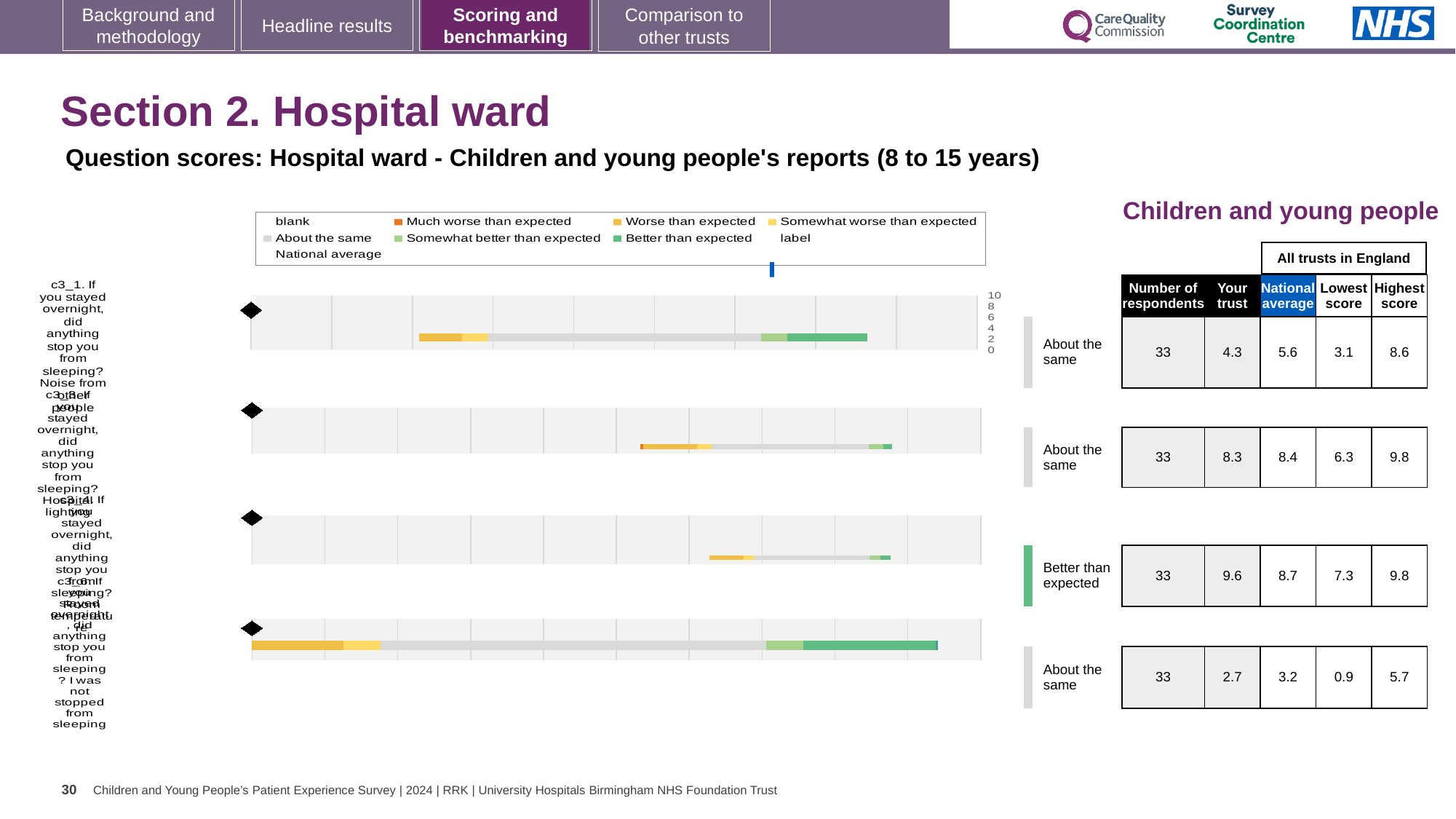
For the first (top) chart, what is the national average score? 5.6 Which chart has the lowest 'Your trust' score? the fourth (bottom) chart (2.7) For the third chart from the top, which is larger: the 'Your trust' score or the national average? Your trust For the fourth (bottom) chart, what is the lowest score among all trusts in England? 0.9 What kind of chart is used to show the question scores on this slide? bar chart Which chart is rated 'Better than expected' rather than 'About the same'? the third chart from the top For the second chart from the top, what is the highest score among all trusts in England? 9.8 For the third chart from the top, what is the 'Your trust' score? 9.6 How many question-score charts are shown on the slide? 4 Which chart has the highest 'Your trust' score? the third chart from the top (9.6) For the first (top) chart, what is the 'Your trust' score? 4.3 For the first (top) chart, what is the difference between the highest score and the lowest score among all trusts in England? 5.5